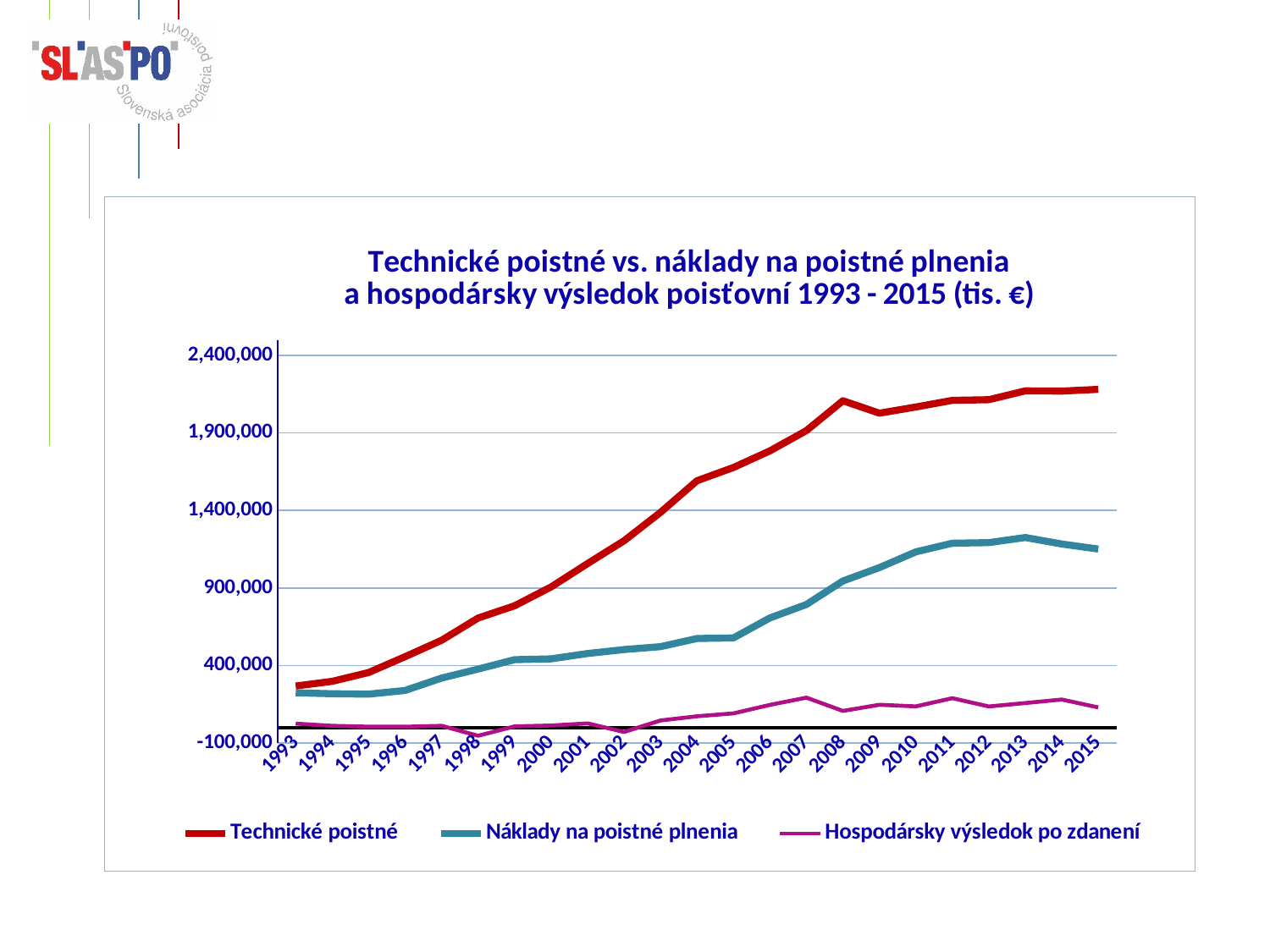
For Hospodársky výsledok po zdanení, which year has the larger value: 2007 or 2008? 2007 Which series is drawn in red? Technické poistné How many series does the legend list? 3 Is the value of Náklady na poistné plnenia in 2015 greater or less than 900,000? greater What kind of chart is shown on the slide? line chart In 2015, which is larger: Technické poistné or Náklady na poistné plnenia? Technické poistné In which year is Technické poistné at its lowest? 1993 Does the Technické poistné line generally rise or fall from 1993 to 2015? rise Is the value of Náklady na poistné plnenia in 2000 greater or less than 900,000? less Is the value of Technické poistné in 1993 greater or less than 400,000? less How many years are plotted along the x axis? 23